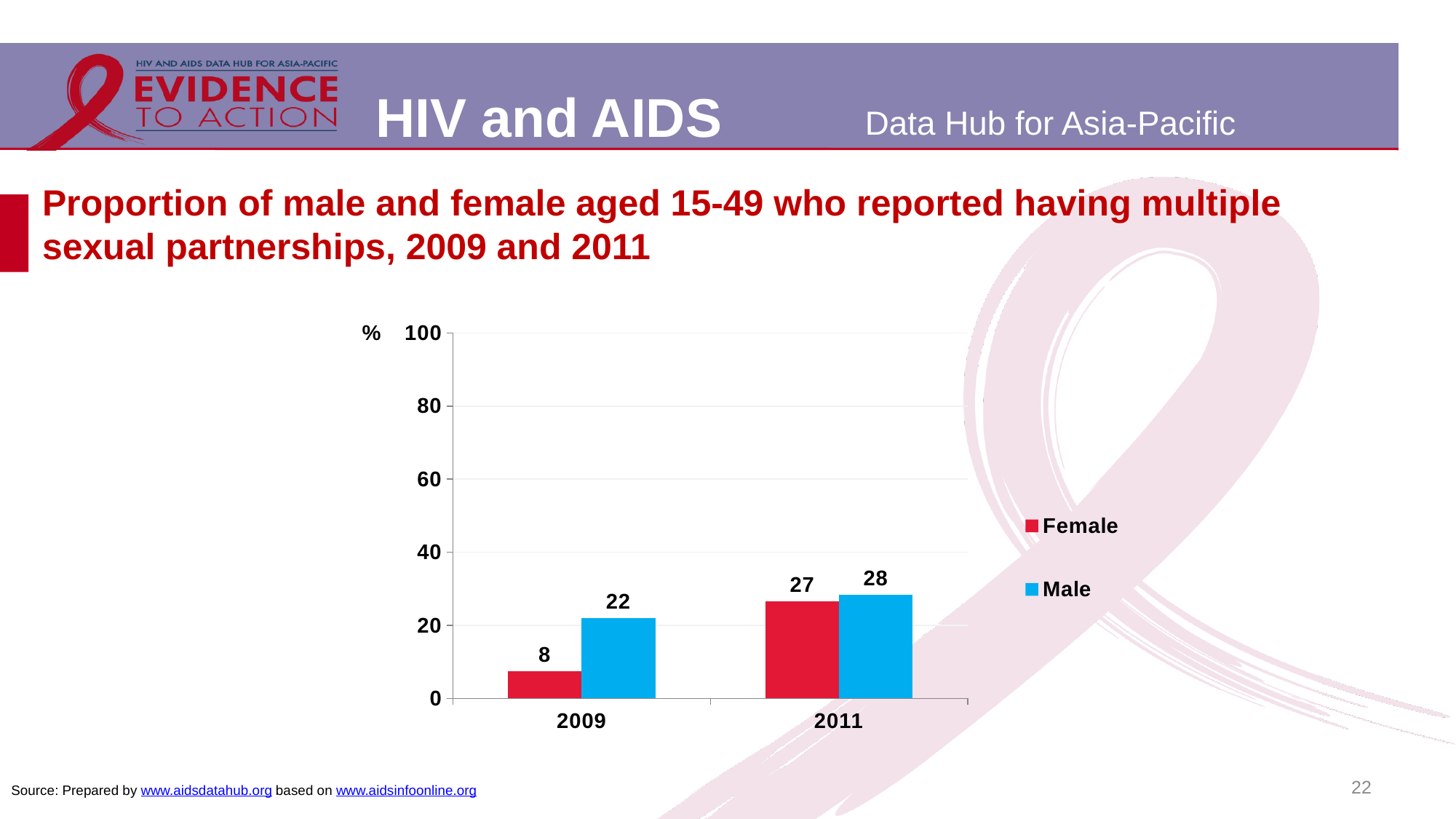
Which series has the lowest value in 2009? Female What is the value for Male in 2009? 22 What is the difference between the Male and Female values in 2009? 14 Which is larger, the Male value in 2009 or the Male value in 2011? Male in 2011 What kind of chart is shown on the slide? bar chart Does the Female value rise or fall from 2009 to 2011? rise How many series does the legend list? 2 What is the value for Male in 2011? 28 Is the value for Male in 2011 greater or less than 20? greater By how much did the Female value increase from 2009 to 2011? 19 What is the value for Female in 2009? 8 What is the value for Female in 2011? 27